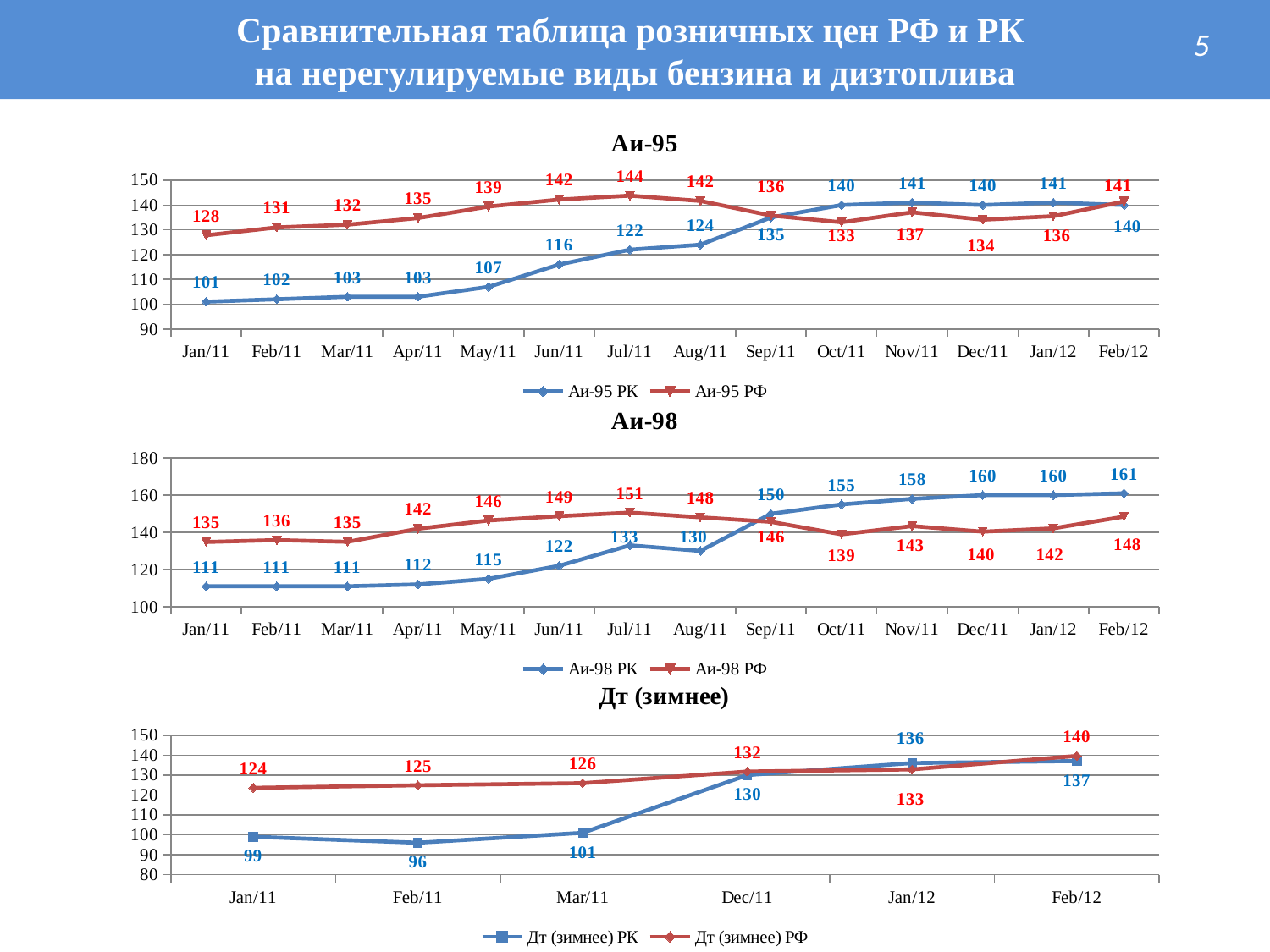
In the Дт (зимнее) chart, how many months are shown on the x axis? 6 In the Аи-95 chart, what is the difference between Аи-95 РФ and Аи-95 РК in Jan/11? 27 In the Дт (зимнее) chart, what is the value of Дт (зимнее) РК in Feb/11? 96 In the Аи-95 chart, which month has the highest value for Аи-95 РФ? Jul/11 In the Аи-95 chart, what is the value of Аи-95 РК in Jan/11? 101 In the Аи-98 chart, which is larger in Oct/11: Аи-98 РК or Аи-98 РФ? Аи-98 РК In the Дт (зимнее) chart, what is the difference between Дт (зимнее) РФ and Дт (зимнее) РК in Jan/11? 25 In the Аи-98 chart, how many series does the legend list? 2 In the Аи-98 chart, what is the value of Аи-98 РК in Feb/12? 161 In the Аи-95 chart, what is the value of Аи-95 РФ in Jul/11? 144 What type of chart is the Аи-95 chart? Line chart In the Аи-98 chart, which month has the lowest value for Аи-98 РФ? Jan/11 and Mar/11 (both 135)